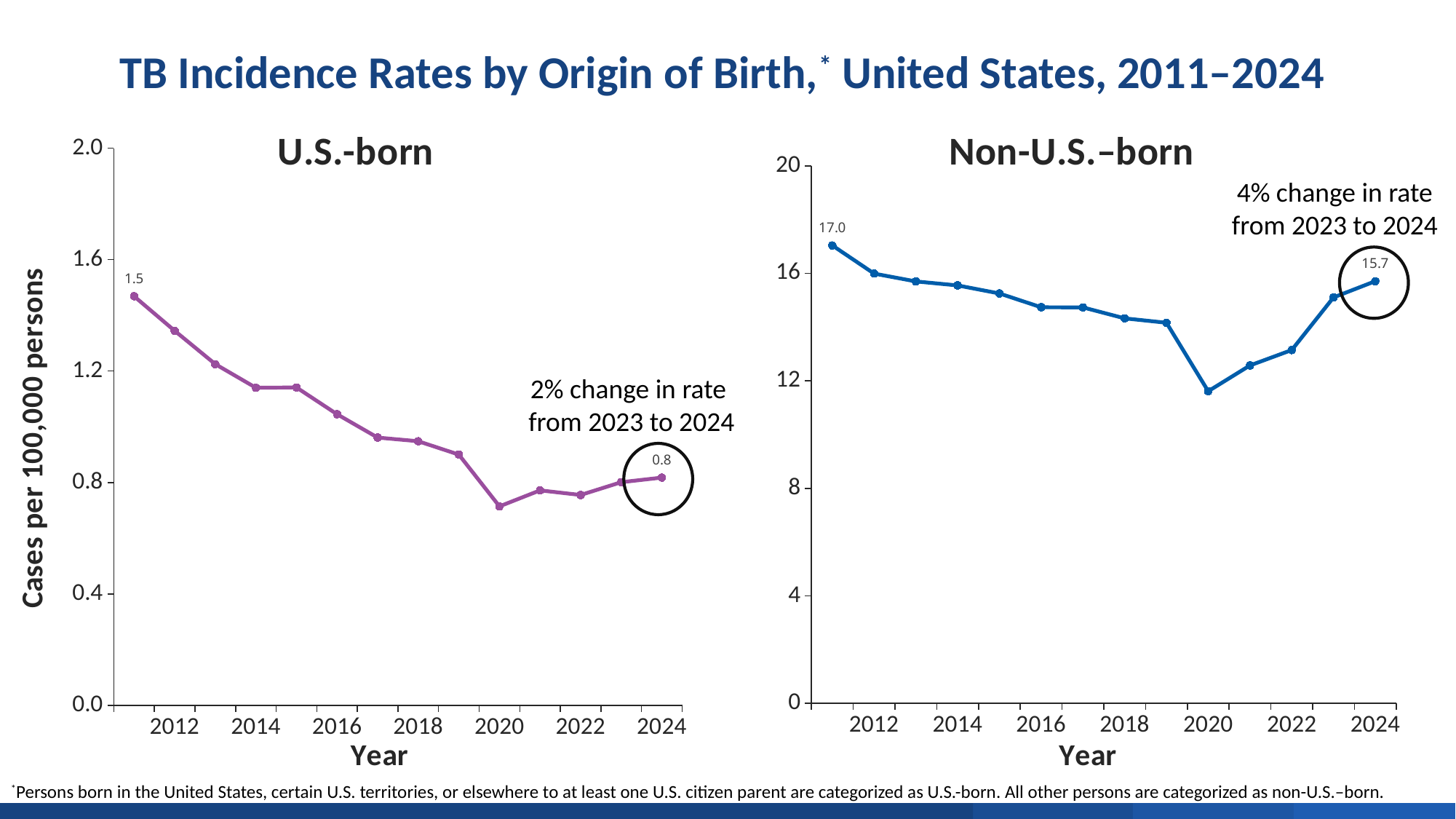
On the U.S.-born chart, what is the TB incidence rate in 2011? 1.5 On the Non-U.S.-born chart, is the value for 2020 greater or less than 12? less On the U.S.-born chart, what is the difference between the 2011 and 2024 rates? 0.7 How many data points are plotted on the U.S.-born chart? 14 On the U.S.-born chart, what is the TB incidence rate in 2024? 0.8 According to the annotation on the Non-U.S.-born chart, what was the percent change in rate from 2023 to 2024? 4% On the Non-U.S.-born chart, which year has the lowest rate? 2020 On the Non-U.S.-born chart, what is the TB incidence rate in 2024? 15.7 On the Non-U.S.-born chart, which year has the highest rate? 2011 On the Non-U.S.-born chart, what is the TB incidence rate in 2011? 17.0 On the Non-U.S.-born chart, what is the difference between the 2011 and 2024 rates? 1.3 What kind of chart is the U.S.-born chart? Line chart